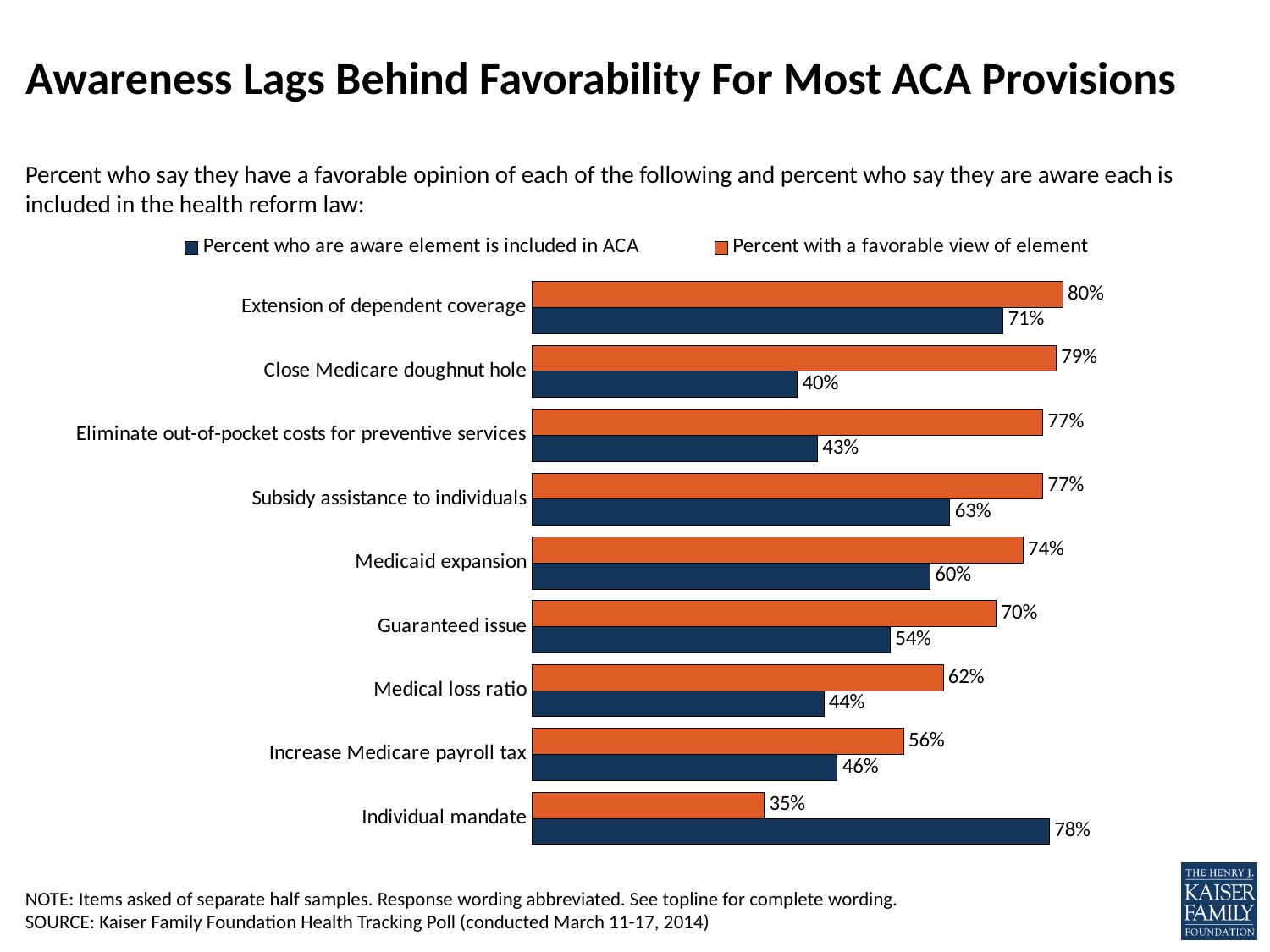
Which provision has the highest percent with a favorable view? Extension of dependent coverage Which provision has the lowest percent with a favorable view? Individual mandate Which provision has the lowest percent who are aware it is included in the ACA? Close Medicare doughnut hole What percent are aware that the individual mandate is included in the ACA? 78% How many provisions are shown in the chart? 9 What percent are aware that Medicaid expansion is included in the ACA? 60% Which colour represents the percent with a favorable view of element? Orange How many series does the legend list? 2 What is the difference between the favorable view and awareness percentages for closing the Medicare doughnut hole? 39 percentage points For the individual mandate, which is larger: the percent aware it is included in the ACA or the percent with a favorable view? Percent who are aware element is included in ACA What percent have a favorable view of closing the Medicare doughnut hole? 79% What type of chart is shown on the slide? Bar chart